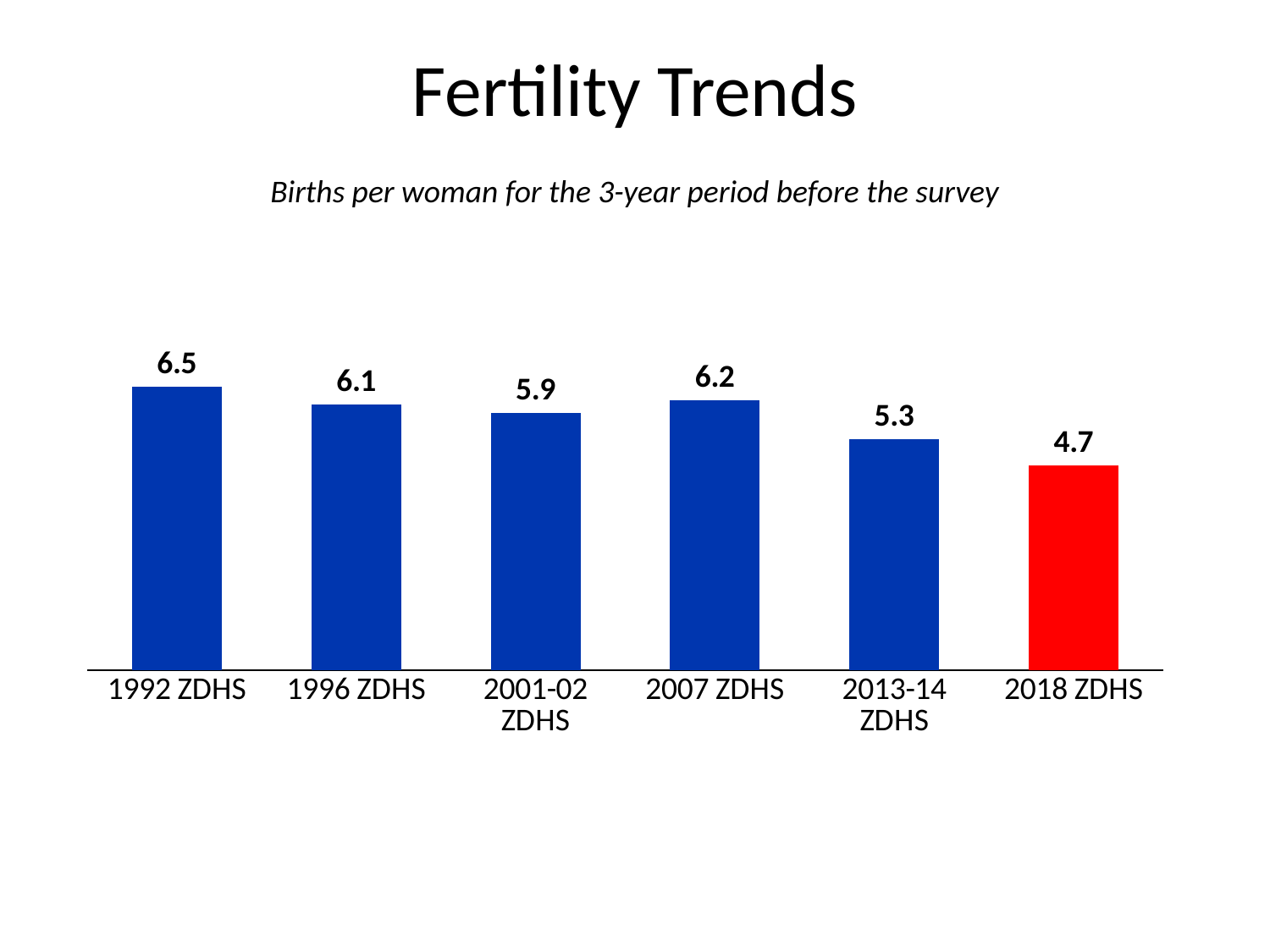
How many surveys are shown on the chart? 6 What is the value for 2018 ZDHS? 4.7 What is the difference between the values for 2007 ZDHS and 2013-14 ZDHS? 0.9 What kind of chart is shown on the slide? bar chart What is the value for 1992 ZDHS? 6.5 Which survey has the lowest value? 2018 ZDHS What is the difference between the values for 1992 ZDHS and 2018 ZDHS? 1.8 Which survey has the highest value? 1992 ZDHS What is the value for 2007 ZDHS? 6.2 Which bar is coloured red? 2018 ZDHS Do the values generally rise or fall from 1992 ZDHS to 2018 ZDHS? fall Which is larger, the value for 1996 ZDHS or the value for 2007 ZDHS? 2007 ZDHS